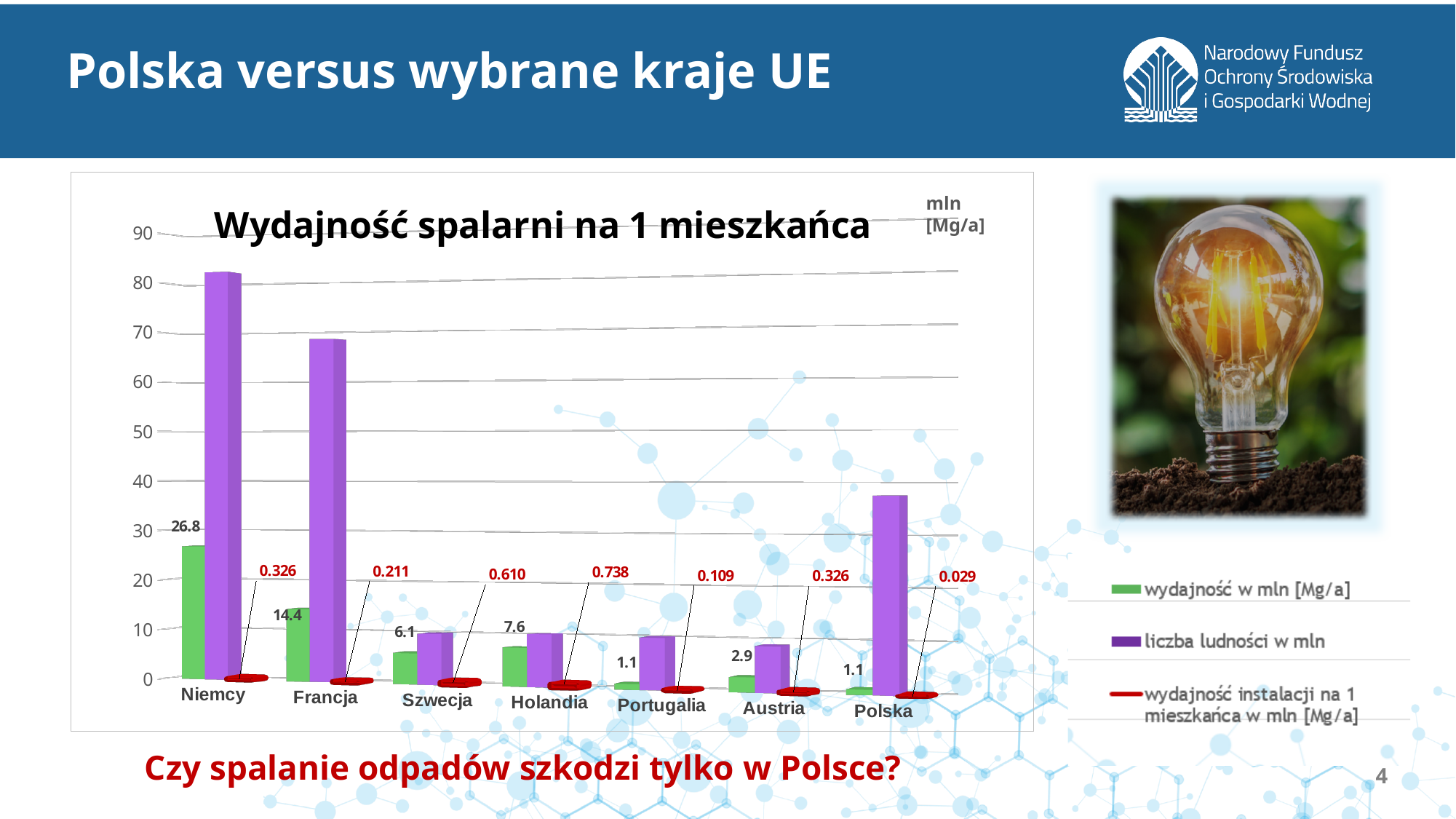
What is the value of wydajność instalacji na 1 mieszkańca w mln [Mg/a] for Holandia? 0.738 Which country has the highest wydajność w mln [Mg/a]? Niemcy Which country has the lowest wydajność instalacji na 1 mieszkańca w mln [Mg/a]? Polska What is the value of wydajność w mln [Mg/a] for Niemcy? 26.8 Is the liczba ludności w mln value for Polska greater or less than 40? less Which has a higher wydajność instalacji na 1 mieszkańca: Szwecja or Austria? Szwecja What is the value of wydajność w mln [Mg/a] for Francja? 14.4 How many series does the legend list? 3 What type of chart is shown on the slide? bar chart How many countries are shown on the chart? 7 What is the difference in wydajność w mln [Mg/a] between Niemcy and Francja? 12.4 What is the value of wydajność instalacji na 1 mieszkańca w mln [Mg/a] for Polska? 0.029